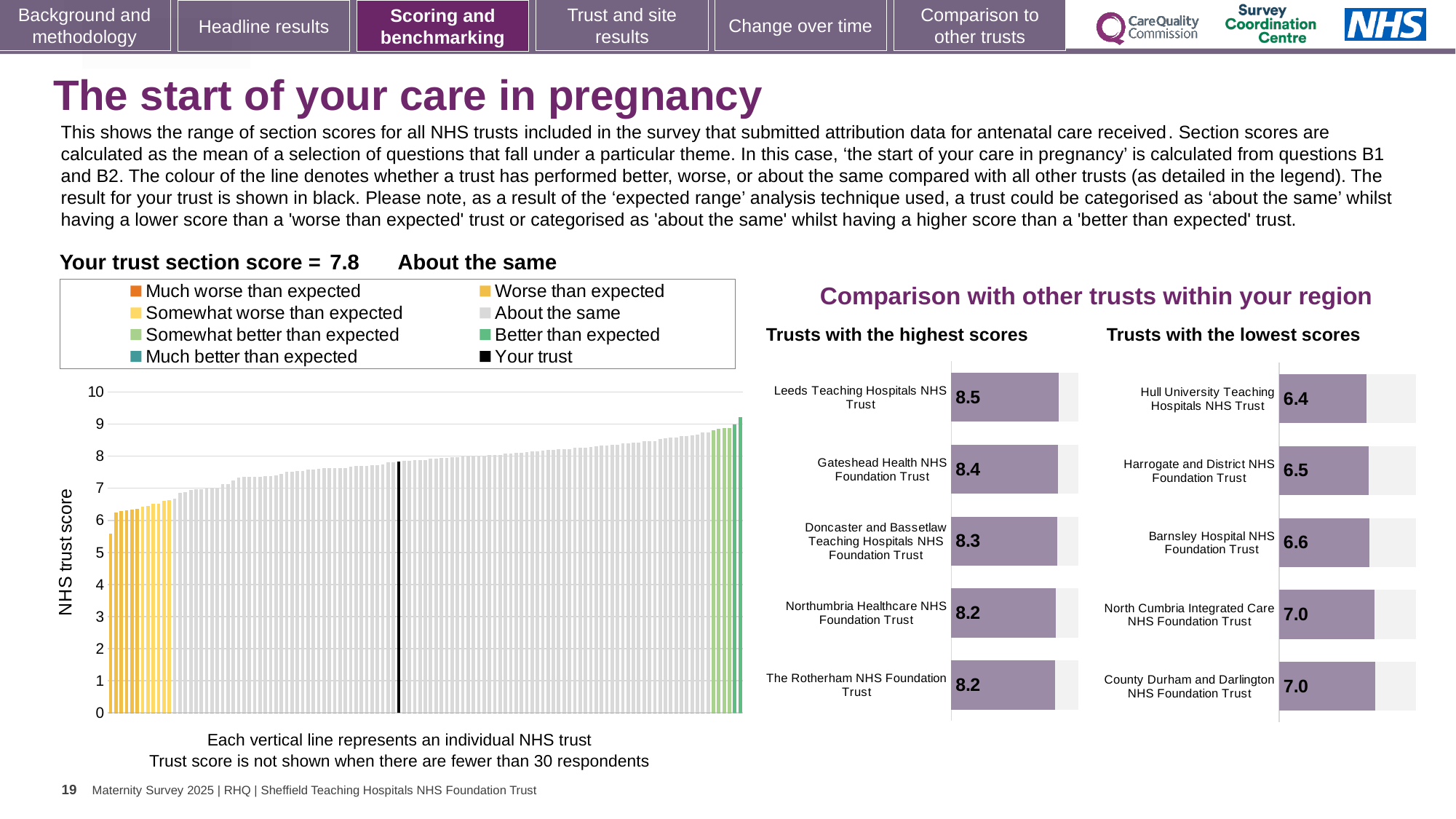
In the large 'NHS trust score' chart on the left, is the value of the lowest bar greater or less than 6? less In the 'Trusts with the lowest scores' chart, what is the difference between the scores of Barnsley Hospital NHS Foundation Trust and Hull University Teaching Hospitals NHS Trust? 0.2 In the large 'NHS trust score' chart on the left, do the values rise or fall from left to right? Rise What kind of chart is the large 'NHS trust score' chart on the left of the slide? Bar chart In the 'Trusts with the lowest scores' chart, what is the score for Hull University Teaching Hospitals NHS Trust? 6.4 In the 'Trusts with the highest scores' chart, what is the difference between the scores of Leeds Teaching Hospitals NHS Trust and Gateshead Health NHS Foundation Trust? 0.1 In the 'Trusts with the lowest scores' chart, which trust has the lowest score? Hull University Teaching Hospitals NHS Trust How many trusts are shown in the 'Trusts with the highest scores' chart? 5 In the 'Trusts with the highest scores' chart, which trust has the highest score? Leeds Teaching Hospitals NHS Trust How many entries does the legend above the large 'NHS trust score' chart list? 8 In the 'Trusts with the highest scores' chart, what is the score for Leeds Teaching Hospitals NHS Trust? 8.5 In the 'Trusts with the lowest scores' chart, which has the higher score: Harrogate and District NHS Foundation Trust or Barnsley Hospital NHS Foundation Trust? Barnsley Hospital NHS Foundation Trust